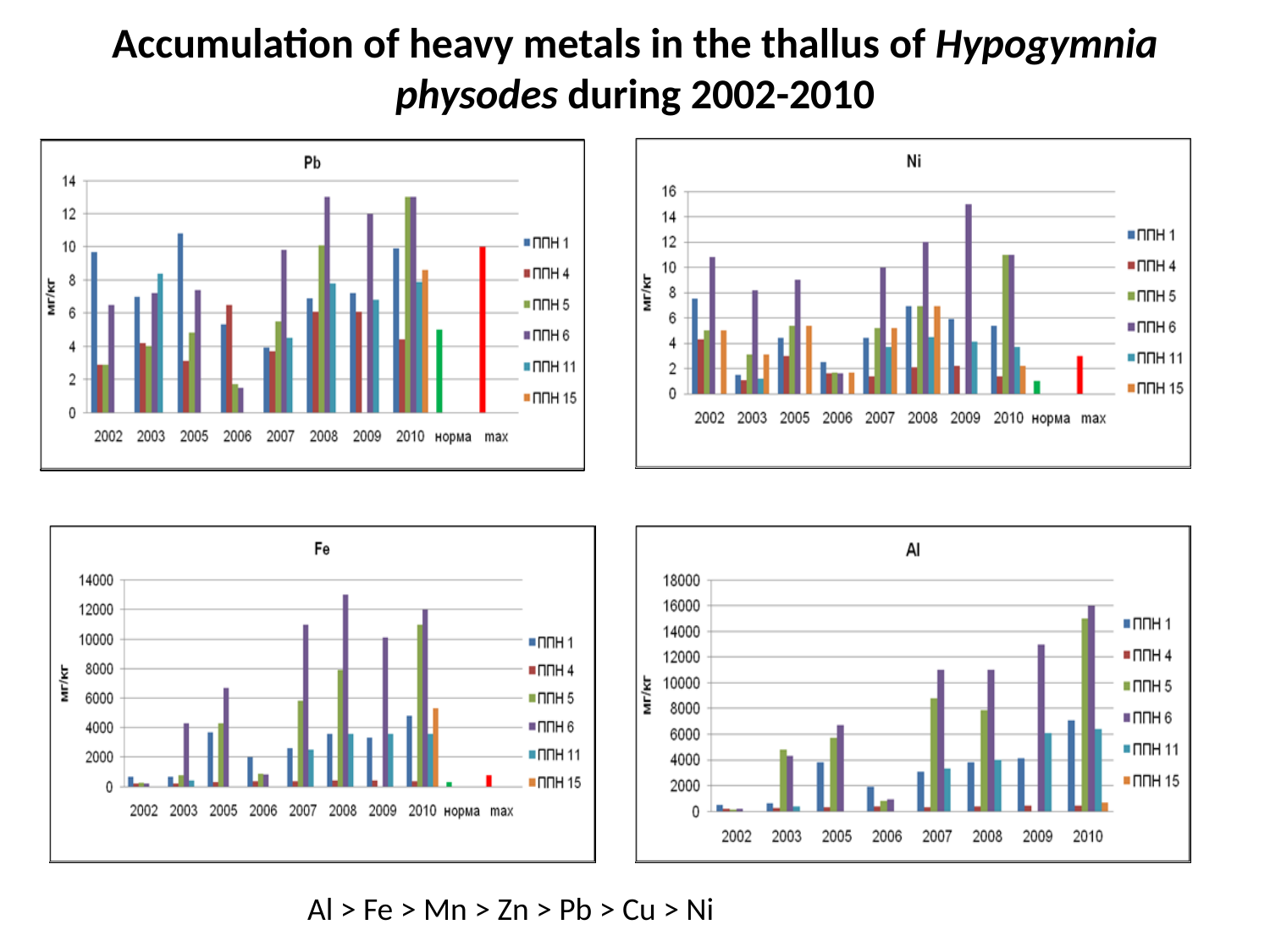
In the Ni chart, which year has the tallest bar for ППН 6? 2009 What is the y-axis label on the Fe chart? мг/кг In the Al chart, which is larger in 2009: ППН 6 or ППН 1? ППН 6 How many categories are shown on the x axis of the Al chart? 8 In the Ni chart, is the value for ППН 6 in 2009 greater or less than 14? greater In the Fe chart, is the value for ППН 1 in 2002 greater or less than 2000? less In the Pb chart, is the value for ППН 6 in 2009 greater or less than 10? greater How many series does the legend of the Ni chart list? 6 How many categories are shown on the x axis of the Fe chart? 10 What kind of chart is the Pb chart at the top left? bar chart